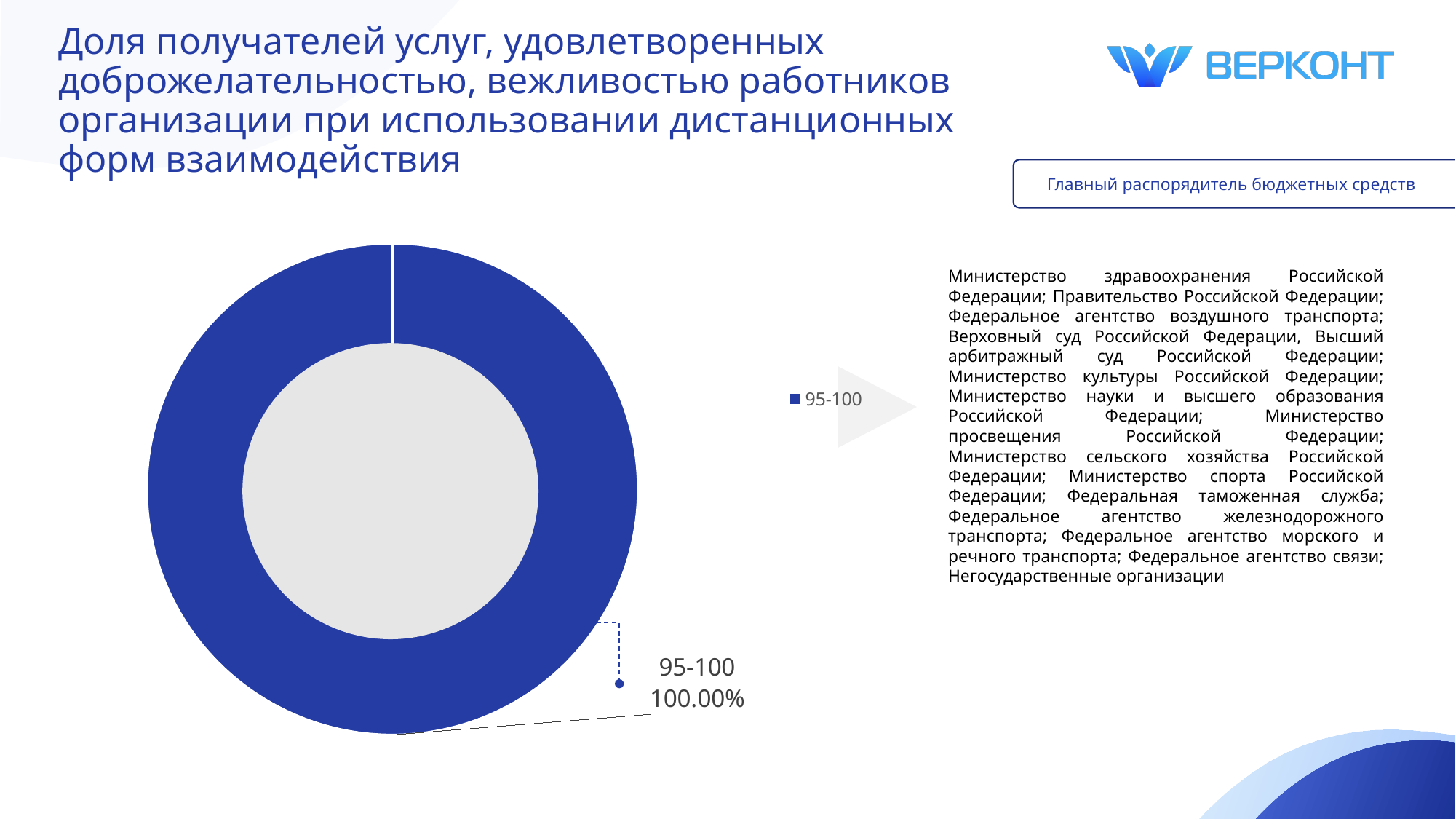
How many slices does the doughnut chart contain? 1 What is the label of the only category in the chart legend? 95-100 What share of the doughnut chart does the "95-100" slice take? 100.00% What is the data label value shown for the "95-100" category? 100.00% What kind of chart is shown on the slide? Doughnut (pie) chart How many entries does the chart legend list? 1 What colour is the "95-100" slice of the doughnut chart? Blue Is the share of the "95-100" slice greater or less than 50%? greater